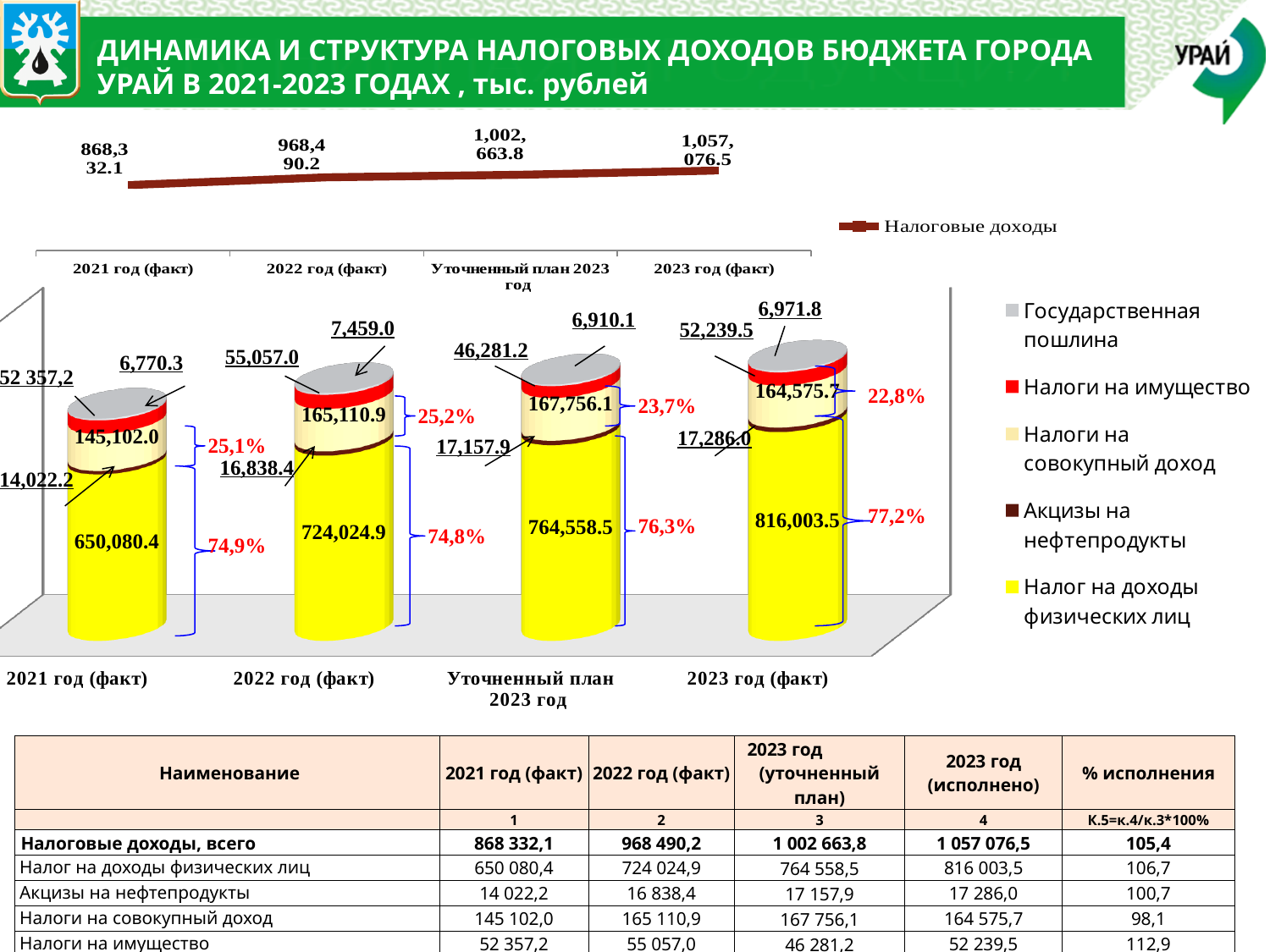
On the top line chart, what is the value of Налоговые доходы for 2023 год (факт)? 1,057,076.5 On the stacked bar chart, what is the value of Налоги на совокупный доход for Уточненный план 2023 год? 167,756.1 On the stacked bar chart, what is the value of Налог на доходы физических лиц for 2022 год (факт)? 724,024.9 How many series does the legend of the stacked bar chart list? 5 On the stacked bar chart, which category has the highest value for Налог на доходы физических лиц? 2023 год (факт) On the stacked bar chart, which category has the lowest value for Акцизы на нефтепродукты? 2021 год (факт) On the top line chart, how many data points are plotted? 4 On the top line chart, do the values of Налоговые доходы rise or fall from 2021 год (факт) to 2023 год (факт)? rise On the stacked bar chart, what is the difference between Налог на доходы физических лиц for 2023 год (факт) and for Уточненный план 2023 год? 51,445.0 On the stacked bar chart, which is larger: Налоги на имущество for 2022 год (факт) or for Уточненный план 2023 год? 2022 год (факт) On the top line chart, what is the value of Налоговые доходы for 2021 год (факт)? 868,332.1 On the stacked bar chart, what is the value of Государственная пошлина for 2023 год (факт)? 6,971.8